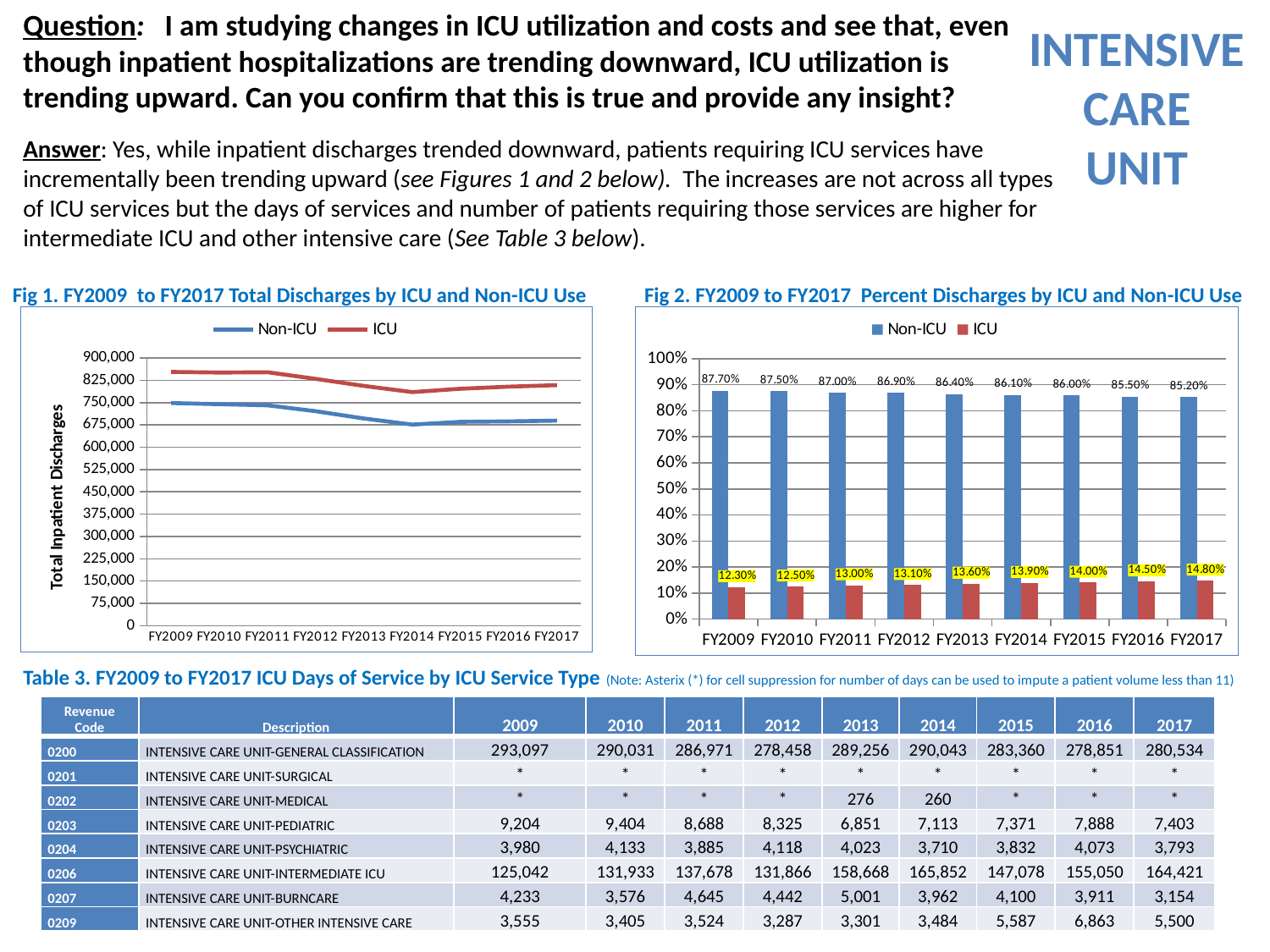
In Fig 2, which fiscal year has the lowest Non-ICU percentage? FY2017 In Fig 2, what is the difference between the ICU percentage in FY2017 and in FY2009? 2.50% In Fig 2, what is the Non-ICU percentage for FY2009? 87.70% In Fig 2, what is the ICU percentage for FY2013? 13.60% In Fig 2, do the ICU percentages rise or fall from FY2009 to FY2017? rise How many fiscal years are shown on the x axis of Fig 1? 9 In Fig 2, which fiscal year has the highest ICU percentage? FY2017 In Fig 2, which is larger, the ICU percentage for FY2012 or for FY2013? FY2013 In Fig 1, is the ICU value for FY2009 greater or less than 825,000? greater In Fig 1, is the Non-ICU value for FY2017 greater or less than 750,000? less In Fig 2, what is the ICU percentage for FY2017? 14.80% What kind of chart is Fig 1? line chart